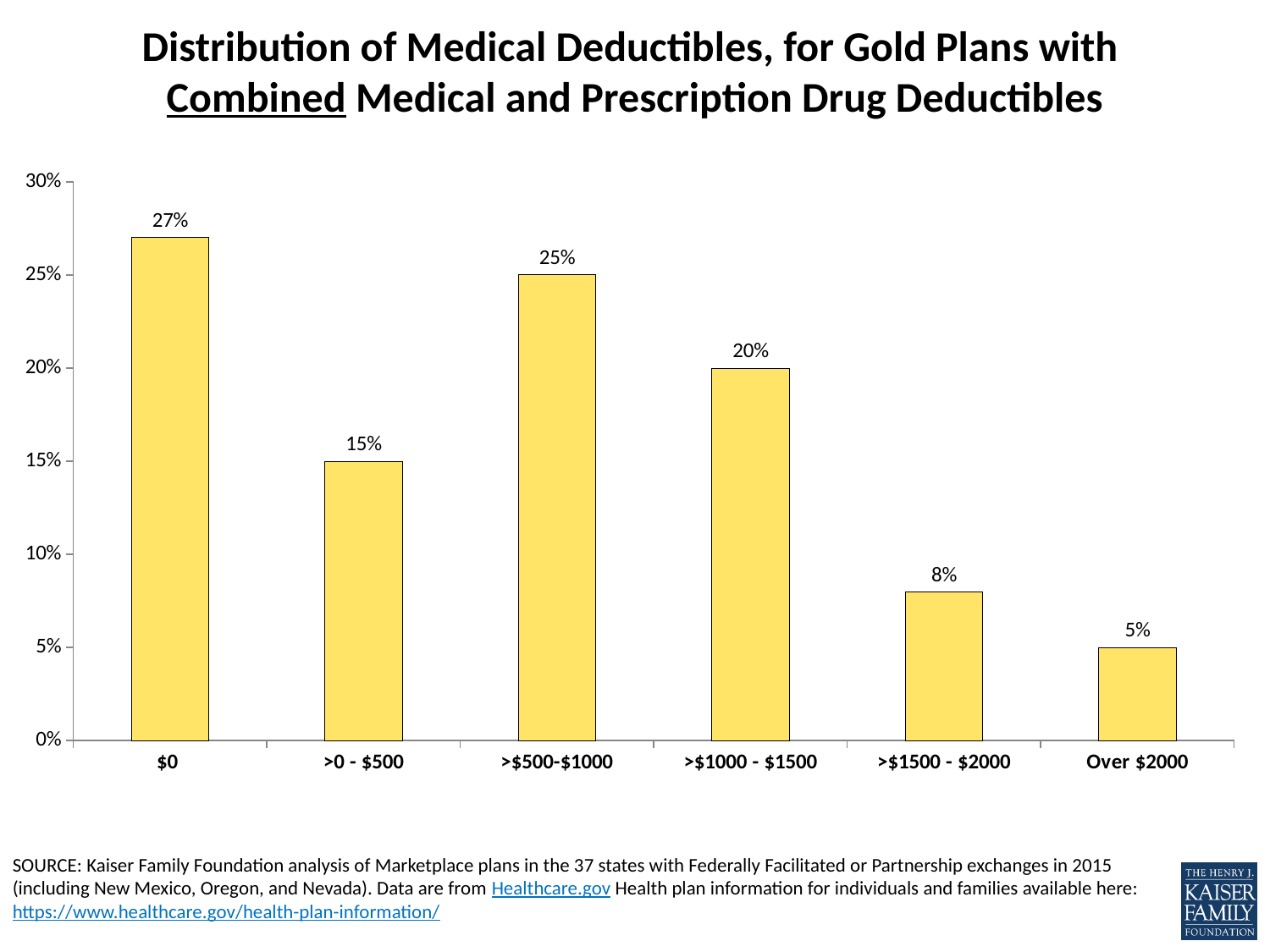
Which deductible category has the highest share of plans? $0 What is the difference between the >$1000 - $1500 and Over $2000 categories? 15% What is the difference between the share for $0 and the share for >0 - $500? 12% What kind of chart is shown on the slide? Bar chart What is the title of the chart? Distribution of Medical Deductibles, for Gold Plans with Combined Medical and Prescription Drug Deductibles What percentage of plans fall in the >$1500 - $2000 category? 8% Which deductible category has the lowest share of plans? Over $2000 What is the value shown for the >$500-$1000 deductible category? 25% How many deductible categories are shown on the x axis? 6 Is the value for >$500-$1000 greater or less than 20%? greater Which is larger, the share for >0 - $500 or the share for >$1000 - $1500? >$1000 - $1500 What percentage of gold plans with combined deductibles have a $0 medical deductible? 27%